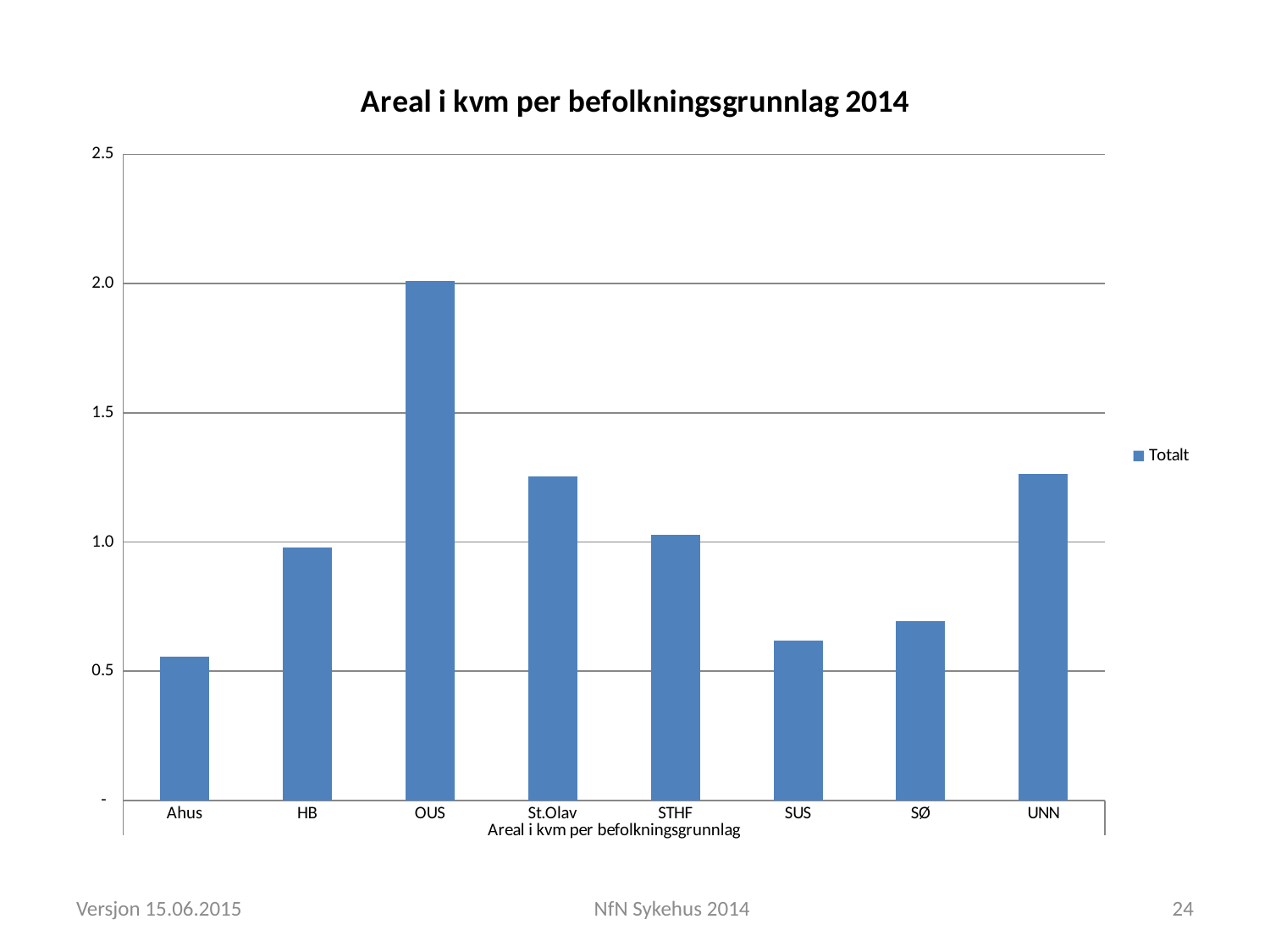
Which is larger, the value for HB or the value for OUS? OUS Is the value for SUS greater or less than 1.0? less How many categories are shown on the x axis? 8 What is the name of the series shown in the legend? Totalt Which category has the highest value? OUS How many series does the legend list? 1 Is the value for OUS greater or less than 1.5? greater What is the title of the chart? Areal i kvm per befolkningsgrunnlag 2014 Is the value for Ahus greater or less than 1.0? less What kind of chart is shown on the slide? Bar chart Which category has the lowest value? Ahus